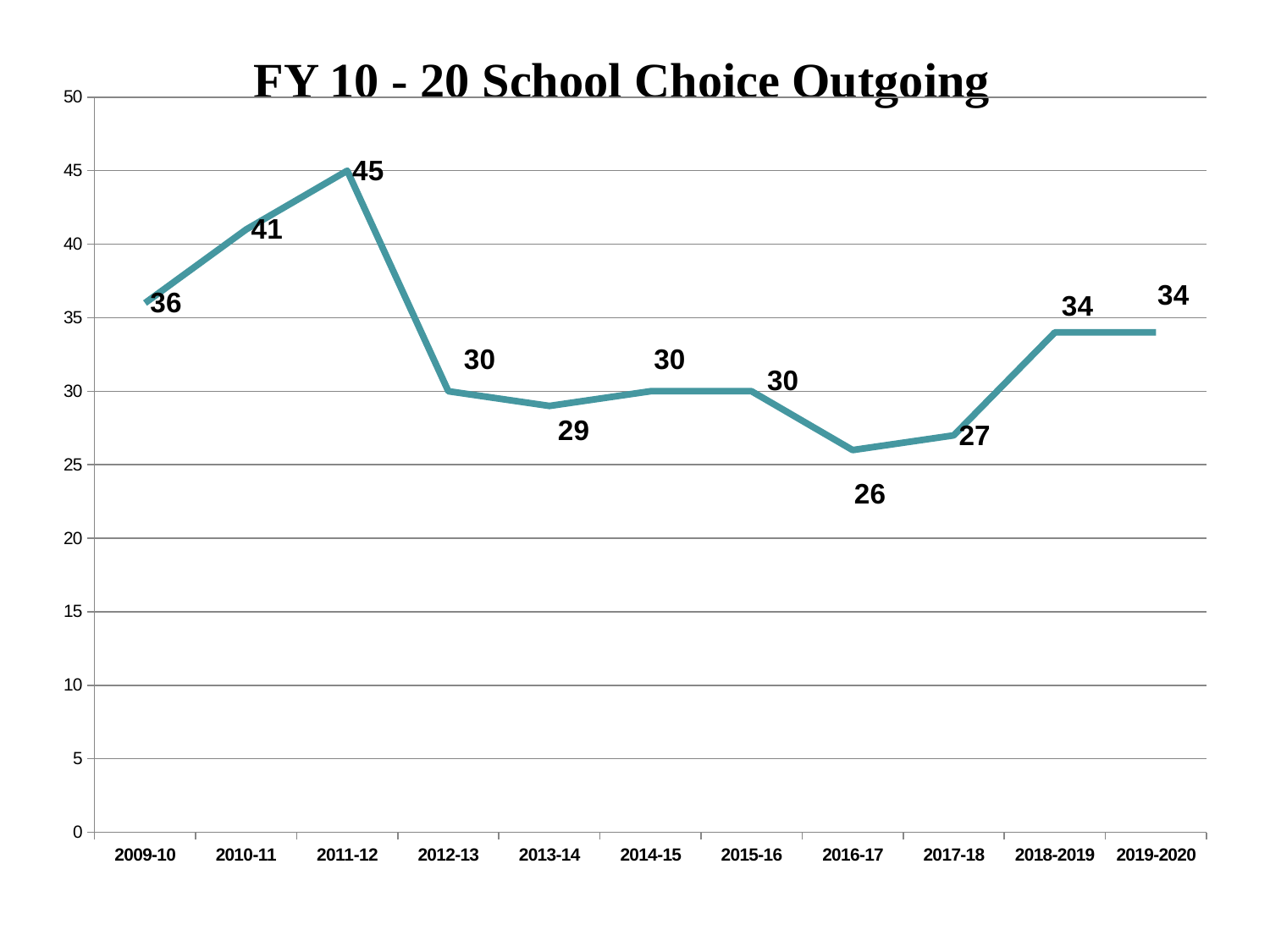
What is the difference between the values for 2018-2019 and 2017-18? 7 What kind of chart is this? line chart What is the value for 2019-2020? 34 What is the value for 2016-17? 26 What is the title of the chart? FY 10 - 20 School Choice Outgoing Which year has the highest value? 2011-12 Is the value for 2010-11 greater or less than 40? greater How many years are plotted on the x axis? 11 Which is larger, the value for 2009-10 or the value for 2013-14? 2009-10 What is the value for 2011-12? 45 What is the difference between the values for 2011-12 and 2012-13? 15 Which year has the lowest value? 2016-17